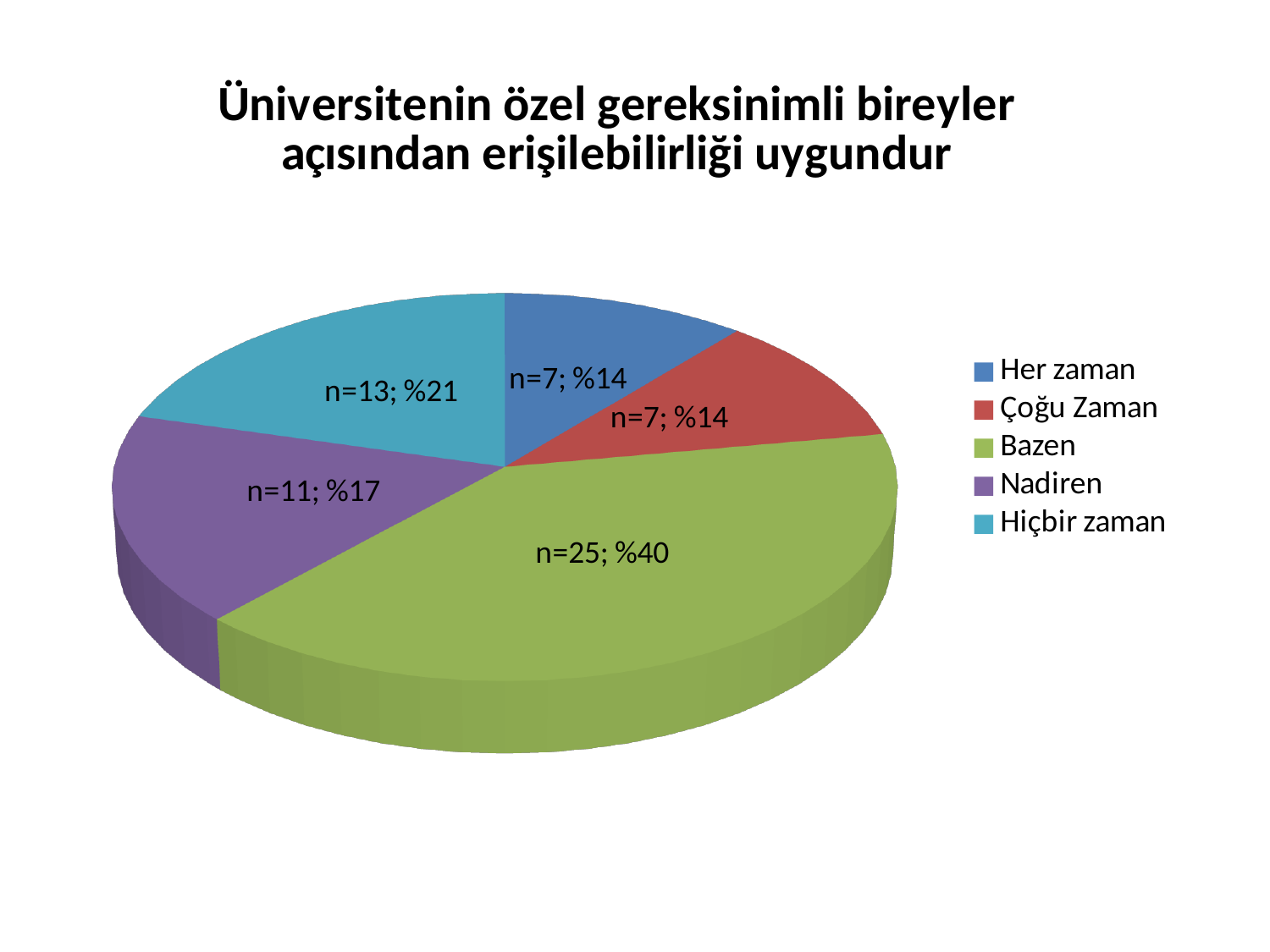
What colour is the Bazen slice? green What kind of chart is shown on the slide? pie chart What is the n value for the Nadiren slice? n=11 Which category has the largest slice? Bazen Which is larger, the Nadiren slice or the Hiçbir zaman slice? Hiçbir zaman What is the n value for the Bazen slice? n=25 What is the difference in n between Bazen and Hiçbir zaman? 12 What percentage share does the Bazen slice have? %40 What is the n value for the Her zaman slice? n=7 How many categories does the legend list? 5 What is the title of the chart? Üniversitenin özel gereksinimli bireyler açısından erişilebilirliği uygundur What percentage share does the Hiçbir zaman slice have? %21